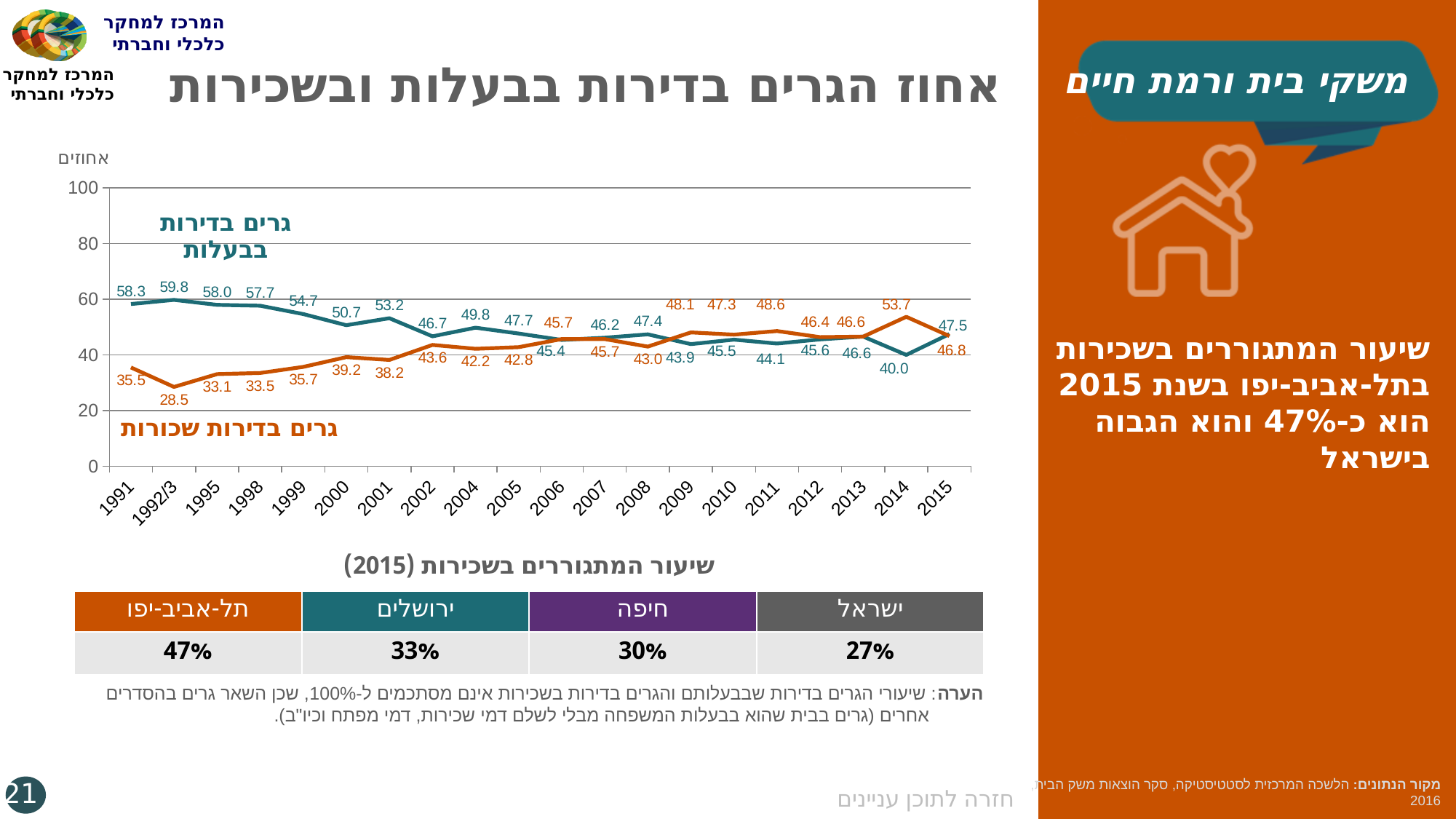
What is the value for גרים בדירות שכורות in 2014? 53.7 In which year is the value for גרים בדירות בבעלות highest? 1992/3 In which year is the value for גרים בדירות שכורות lowest? 1992/3 Does the value for גרים בדירות שכורות generally rise or fall from 1992/3 to 2014? rise What type of chart is shown on the slide? line chart What is the difference between גרים בדירות בבעלות and גרים בדירות שכורות in 1991? 22.8 In 2014, which series has the larger value, גרים בדירות בבעלות or גרים בדירות שכורות? גרים בדירות שכורות What is the value for גרים בדירות שכורות in 2015? 46.8 How many years are shown on the x axis of the chart? 20 What is the title of the chart? אחוז הגרים בדירות בבעלות ובשכירות Is the value for גרים בדירות שכורות in 1992/3 greater or less than 40? less What is the value for גרים בדירות בבעלות in 1991? 58.3